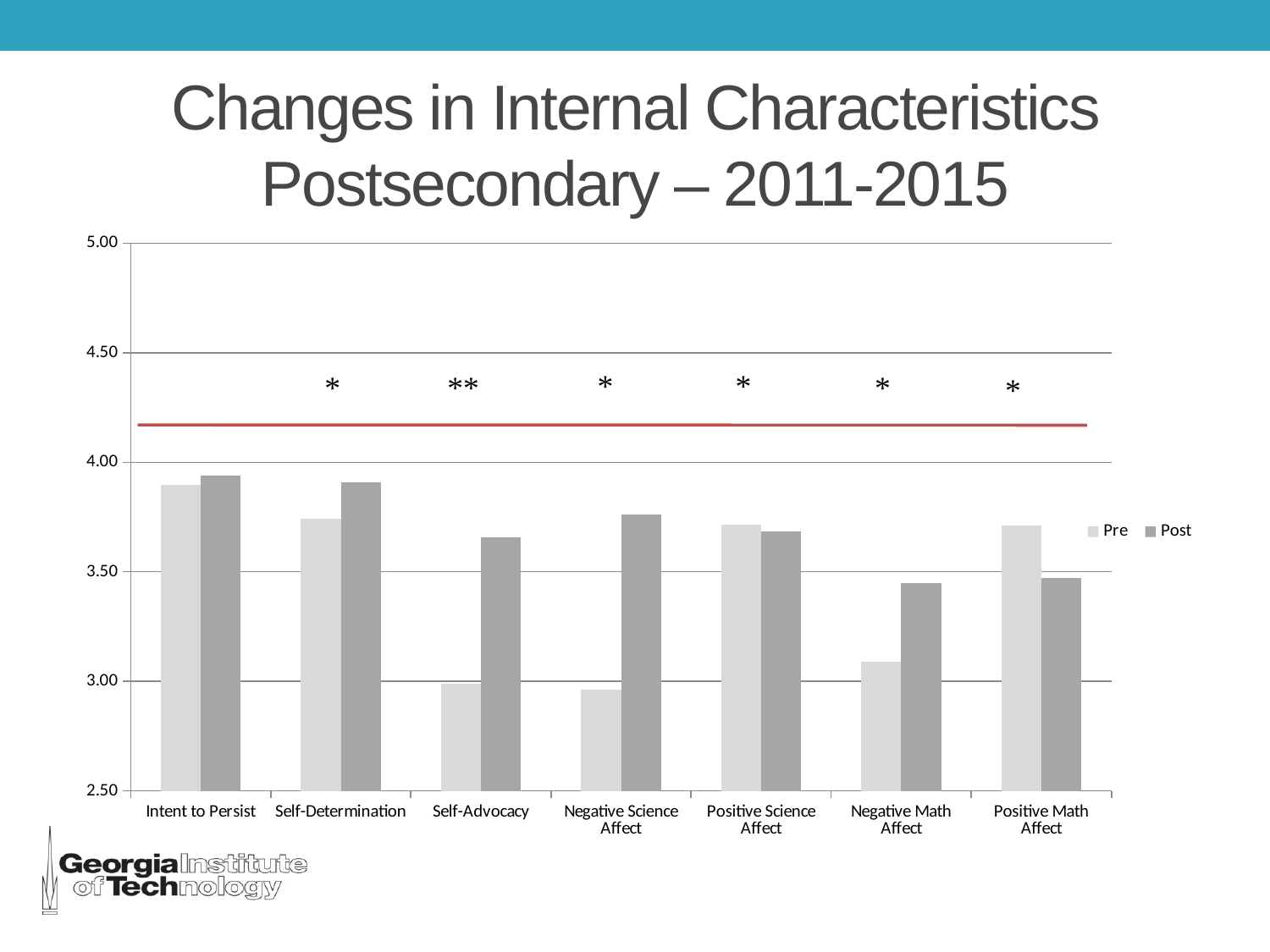
How many series does the chart's legend list? 2 Is the Post value for Negative Science Affect greater or less than 3.50? greater Which is larger for Negative Science Affect, the Pre value or the Post value? Post Which category has the highest Pre value? Intent to Persist How many categories are shown along the x axis of the chart? 7 What kind of chart is shown on the slide? bar chart Which is larger for Positive Math Affect, the Pre value or the Post value? Pre Which is larger for Self-Advocacy, the Pre value or the Post value? Post Is the Post value for Intent to Persist greater or less than 4.00? less Is the Pre value for Negative Math Affect greater or less than 3.50? less What are the two series named in the chart's legend? Pre and Post